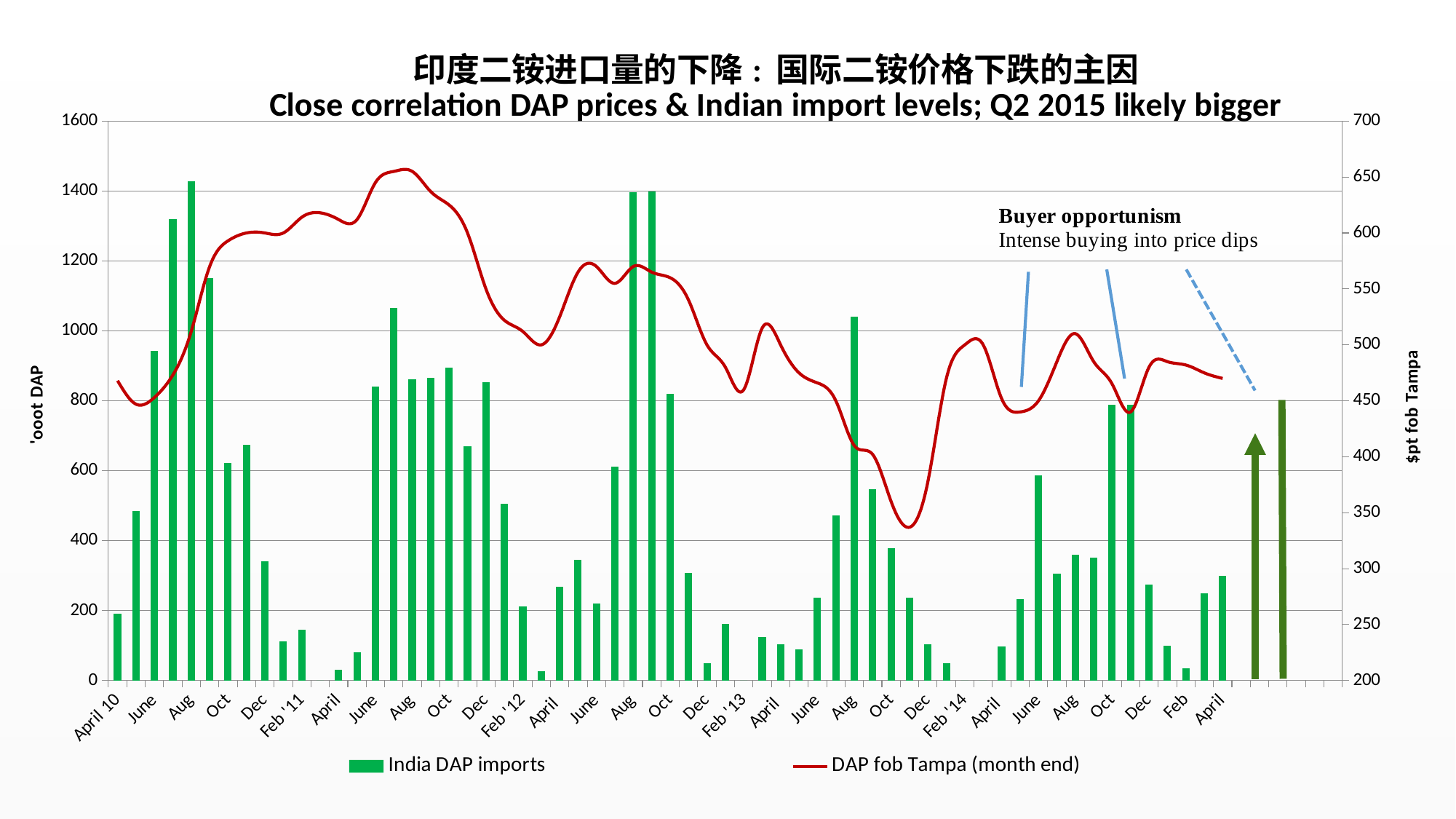
Is the India DAP imports value for April 10 greater or less than 400? less Around which month does the DAP fob Tampa line reach its lowest point? Nov 2013 What is the label of the right-hand vertical axis? $pt fob Tampa Is the DAP fob Tampa price in Oct 2014 greater or less than 500? less Is the DAP fob Tampa price in Dec 2013 greater or less than 400? less How many series does the legend list? 2 Which series is drawn as green bars? India DAP imports Which is larger, the India DAP imports bar for Aug 2010 or for Oct 2010? Aug 2010 Around which month does the DAP fob Tampa line reach its highest point? Aug 2011 What kind of chart is shown on the slide? A combined bar and line chart